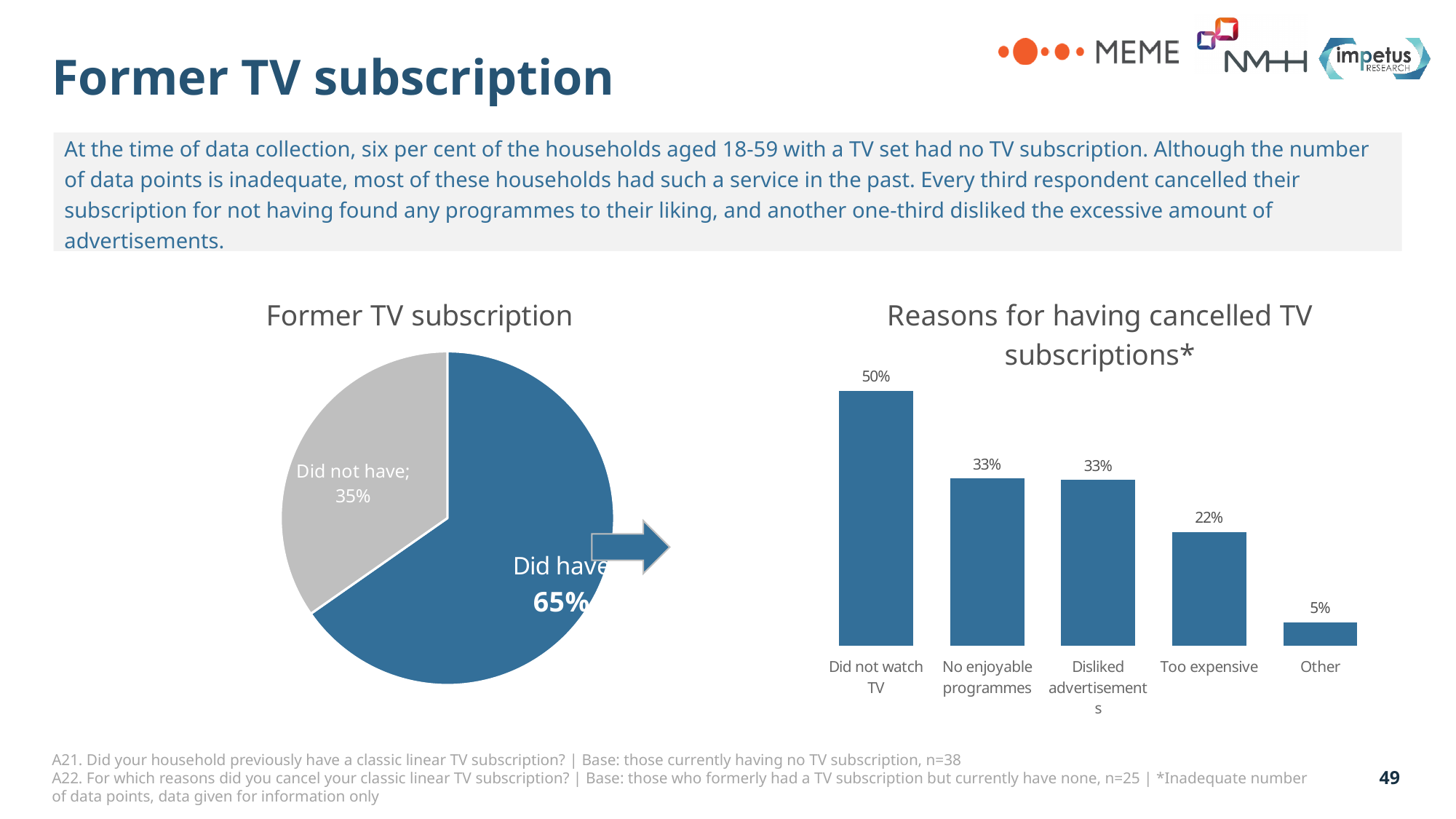
In the 'Reasons for having cancelled TV subscriptions*' chart, which reason has the lowest value? Other What kind of chart is the 'Former TV subscription' chart on the left? Pie chart In the 'Reasons for having cancelled TV subscriptions*' chart, what is the value for 'Did not watch TV'? 50% In the 'Former TV subscription' pie chart, which slice is larger, 'Did have' or 'Did not have'? Did have In the 'Reasons for having cancelled TV subscriptions*' chart, how many reasons are shown? 5 In the 'Reasons for having cancelled TV subscriptions*' chart, what is the value for 'Too expensive'? 22% In the 'Former TV subscription' pie chart, what share of households did have a TV subscription? 65% In the 'Reasons for having cancelled TV subscriptions*' chart, what is the difference between 'Did not watch TV' and 'Too expensive'? 28% In the 'Former TV subscription' pie chart, how many slices are there? 2 In the 'Reasons for having cancelled TV subscriptions*' chart, which reason has the highest value? Did not watch TV What kind of chart is the 'Reasons for having cancelled TV subscriptions*' chart on the right? Bar chart In the 'Former TV subscription' pie chart, what share of households did not have a TV subscription? 35%